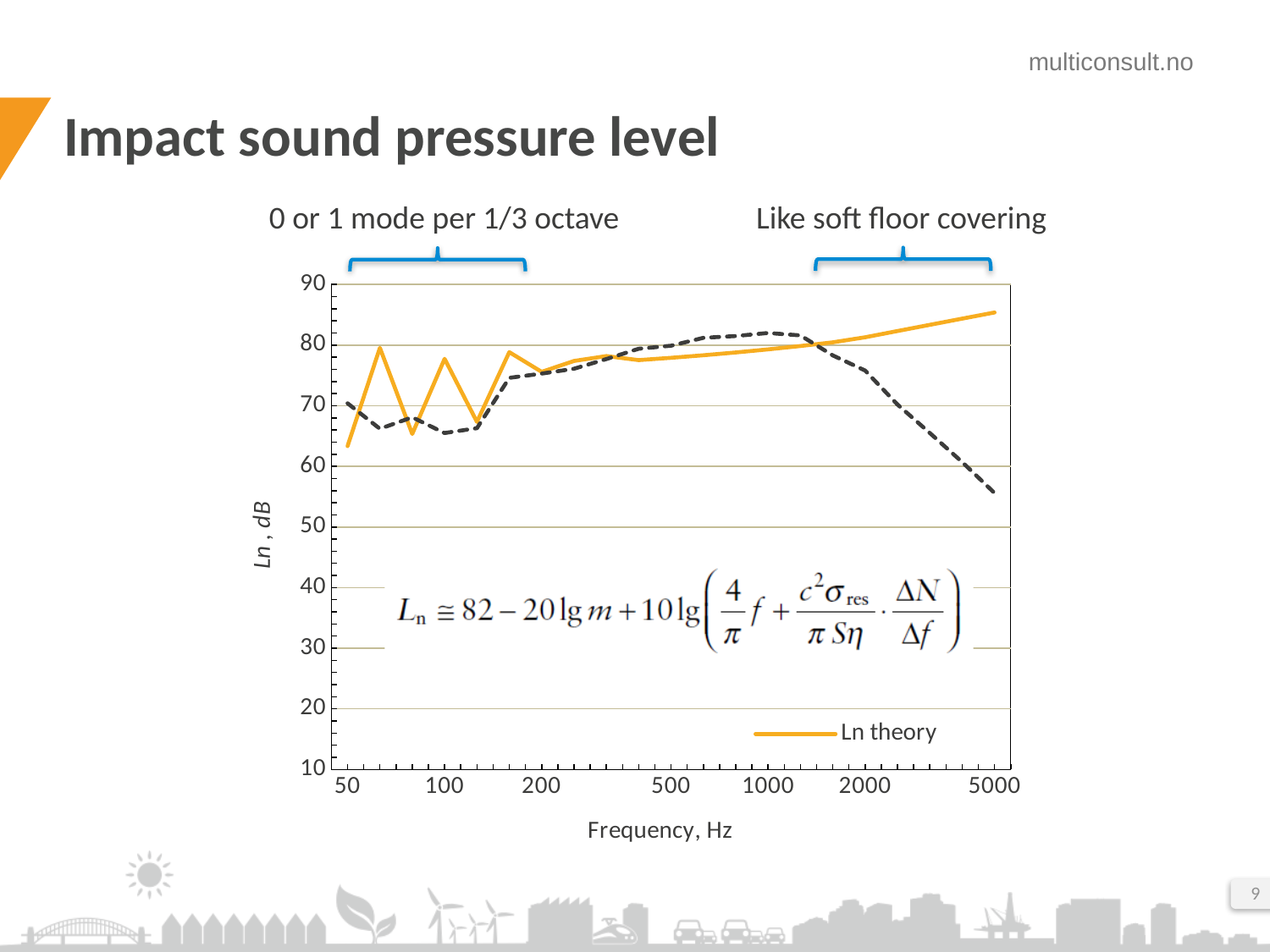
At 5000 Hz, which is larger: the Ln theory line or the dashed line? Ln theory How many series does the chart legend list? 1 Is the value of Ln theory at 50 Hz greater or less than 60? greater Is the value of the dashed line at 5000 Hz greater or less than 60? less Does the dashed line rise or fall between 1000 Hz and 5000 Hz? fall What is the name of the series listed in the legend? Ln theory What is the label of the x axis? Frequency, Hz Does the Ln theory line rise or fall between 200 Hz and 5000 Hz? rise At 50 Hz, which is larger: the Ln theory line or the dashed line? the dashed line Is the value of the dashed line at 2000 Hz greater or less than 80? less What kind of chart is shown on the slide? line chart